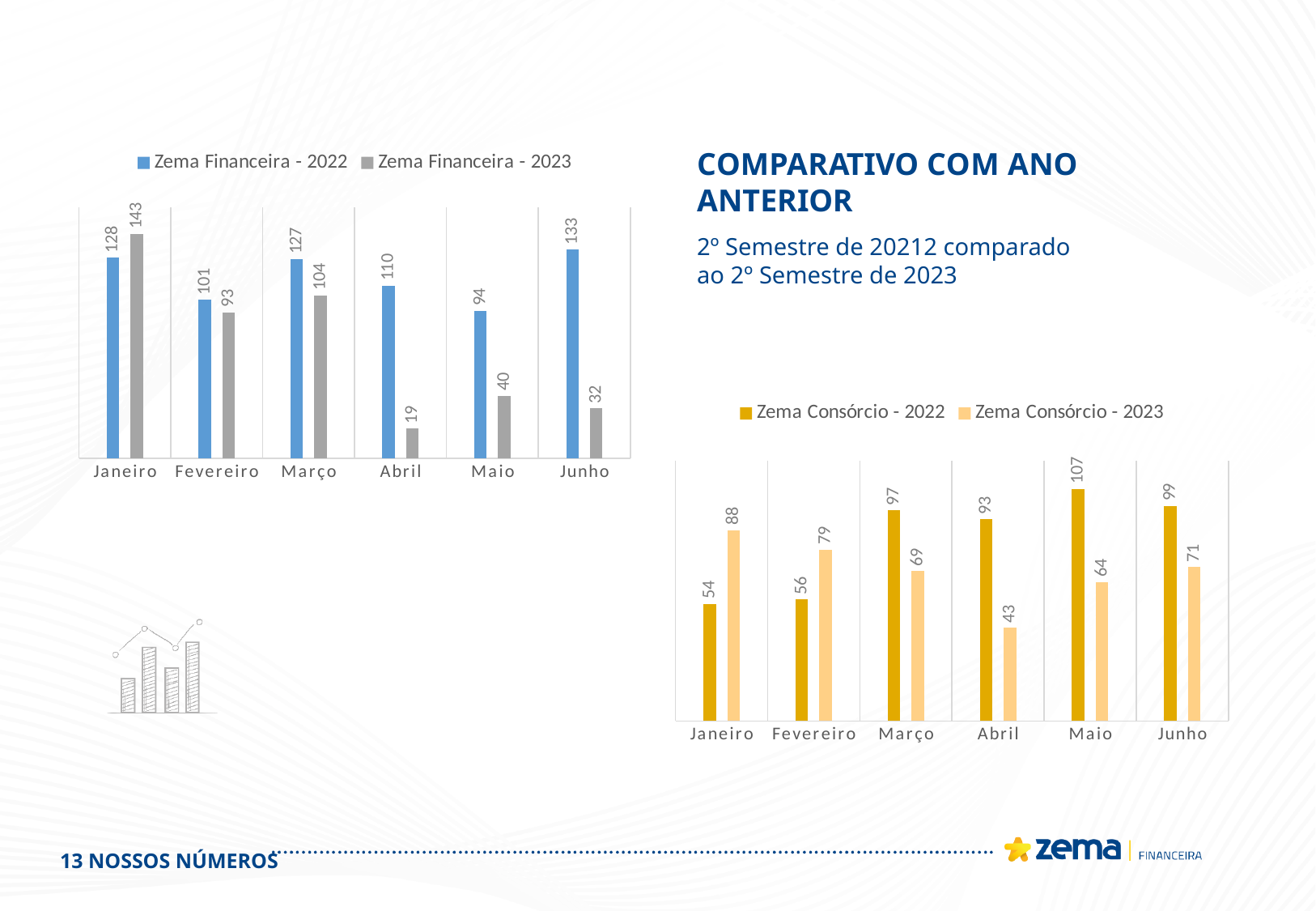
In the left chart (Zema Financeira), which month has the highest value for Zema Financeira - 2022? Junho In the right chart (Zema Consórcio), what is the difference between the 2022 and 2023 values in Março? 28 How many months are shown on the x axis of the right chart (Zema Consórcio)? 6 In the right chart (Zema Consórcio), what is the value for Zema Consórcio - 2022 in Maio? 107 In the left chart (Zema Financeira), what is the value for Zema Financeira - 2022 in Maio? 94 In the right chart (Zema Consórcio), what is the value for Zema Consórcio - 2023 in Abril? 43 In the left chart (Zema Financeira), which month has the lowest value for Zema Financeira - 2023? Abril What type of chart is the left chart (Zema Financeira)? Bar chart In the left chart (Zema Financeira), what is the value for Zema Financeira - 2023 in Janeiro? 143 In the left chart (Zema Financeira), what is the difference between the 2022 and 2023 values in Junho? 101 In the right chart (Zema Consórcio), which is larger in Janeiro: Zema Consórcio - 2022 or Zema Consórcio - 2023? Zema Consórcio - 2023 In the left chart (Zema Financeira), how many series does the legend list? 2